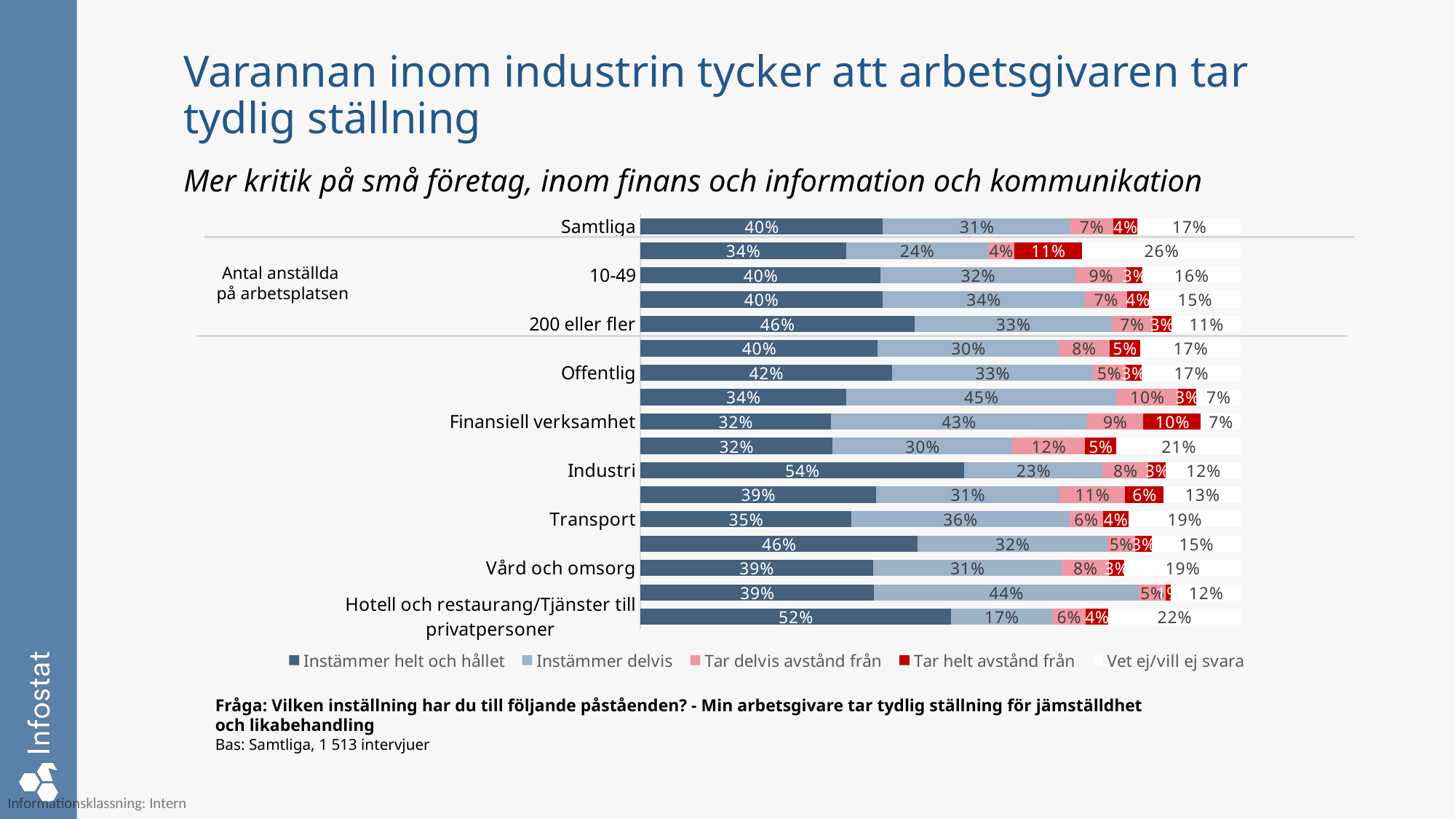
Which has a larger 'Instämmer delvis' value, Finansiell verksamhet or Industri? Finansiell verksamhet What is the 'Instämmer helt och hållet' value for Industri? 54% Which legend entry is shown in dark red? Tar helt avstånd från What is the 'Tar helt avstånd från' value for Finansiell verksamhet? 10% How many series does the legend list? 5 What is the 'Instämmer delvis' value for Hotell och restaurang/Tjänster till privatpersoner? 17% What kind of chart is shown on the slide? Stacked bar chart How many bars (rows) are plotted in the chart? 17 What is the 'Tar delvis avstånd från' value for Transport? 6% What is the 'Vet ej/vill ej svara' value for Samtliga? 17% What is the difference in 'Instämmer helt och hållet' between Industri and Samtliga? 14 percentage points Which row has the highest 'Instämmer helt och hållet' value? Industri